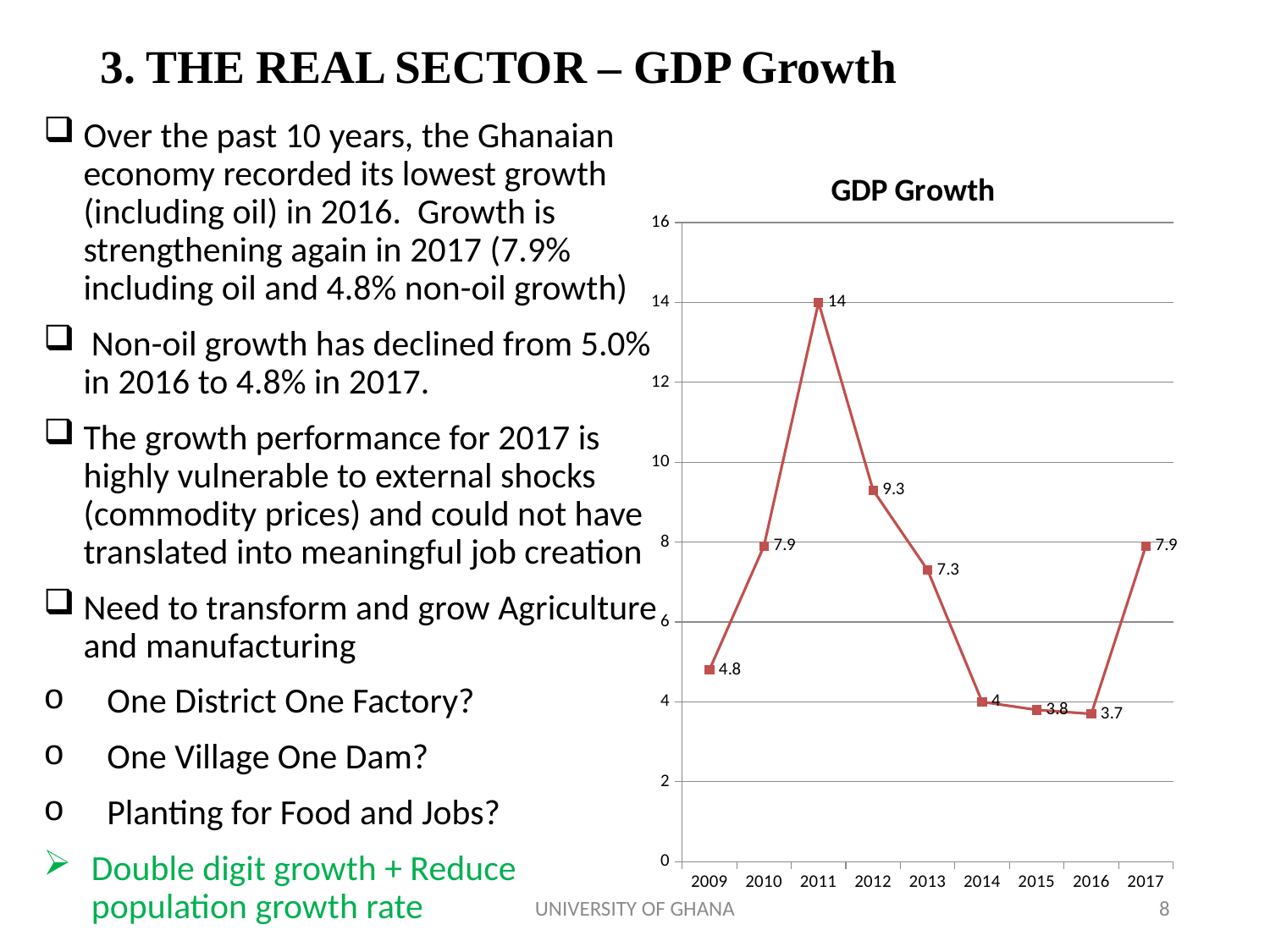
What is the GDP growth value for 2011? 14 Which year has a higher GDP growth value, 2013 or 2014? 2013 Which year has the highest GDP growth? 2011 How many years are plotted on the GDP Growth chart? 9 What is the title of the chart? GDP Growth What is the GDP growth value for 2012? 9.3 What is the difference between the GDP growth values for 2011 and 2012? 4.7 Which year has the lowest GDP growth? 2016 What is the GDP growth value for 2016? 3.7 Does GDP growth rise or fall from 2012 to 2016? fall Is the GDP growth value for 2009 greater or less than 6? less What kind of chart is shown on the slide? line chart